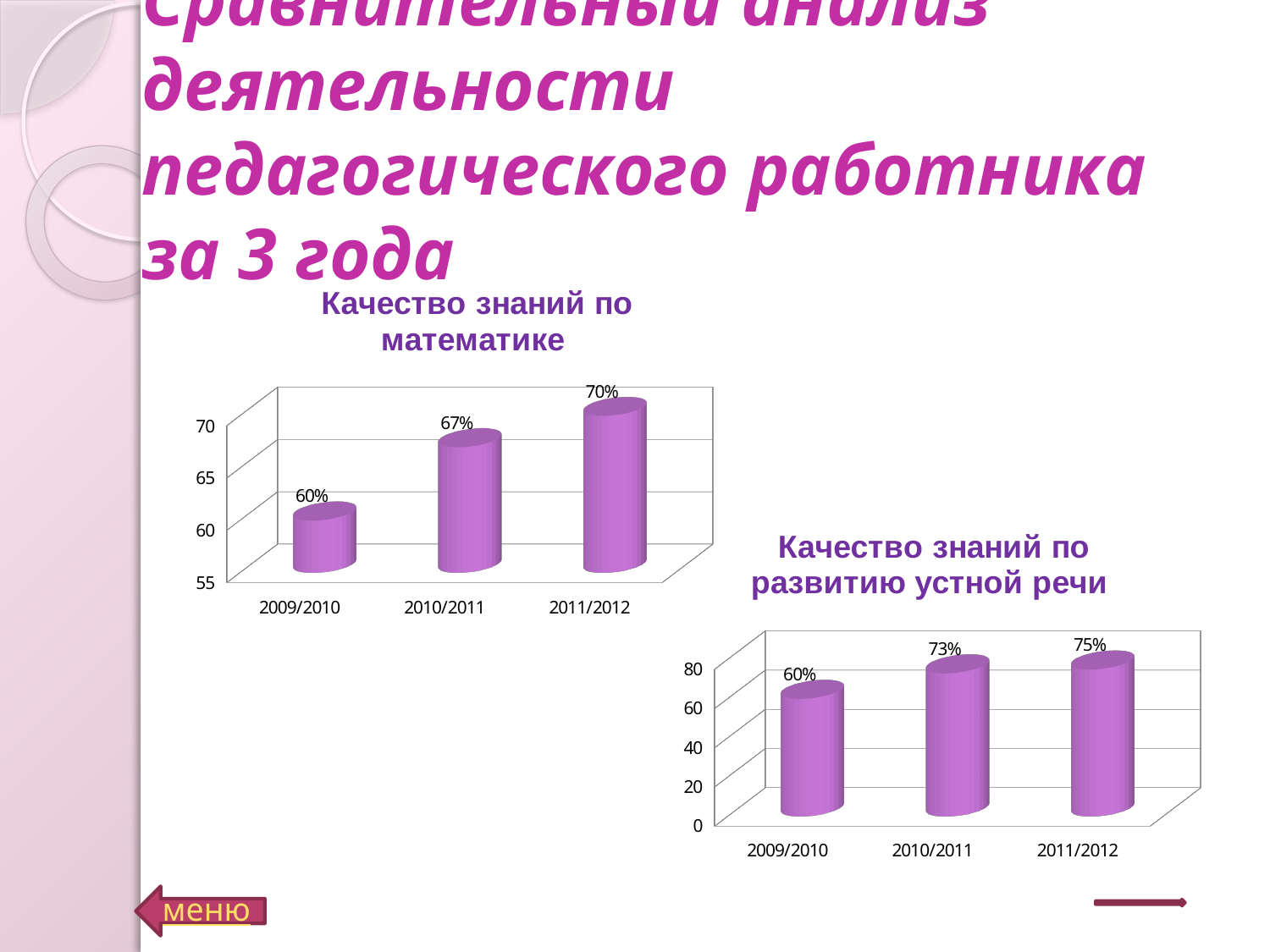
How many categories are shown in the chart 'Качество знаний по развитию устной речи'? 3 In the chart 'Качество знаний по математике', what is the difference between the values for 2011/2012 and 2009/2010? 10% In the chart 'Качество знаний по математике', which is larger: the value for 2010/2011 or 2009/2010? 2010/2011 In the chart 'Качество знаний по развитию устной речи', what is the value for 2010/2011? 73% In the chart 'Качество знаний по развитию устной речи', what is the difference between the values for 2010/2011 and 2009/2010? 13% In the chart 'Качество знаний по математике', what is the value for 2009/2010? 60% In the chart 'Качество знаний по математике', what is the value for 2011/2012? 70% In the chart 'Качество знаний по развитию устной речи', what is the value for 2011/2012? 75% What kind of chart is 'Качество знаний по математике'? Bar chart In the chart 'Качество знаний по развитию устной речи', which year has the lowest value? 2009/2010 In the chart 'Качество знаний по математике', which year has the highest value? 2011/2012 In the chart 'Качество знаний по развитию устной речи', do the values rise or fall from 2009/2010 to 2011/2012? Rise